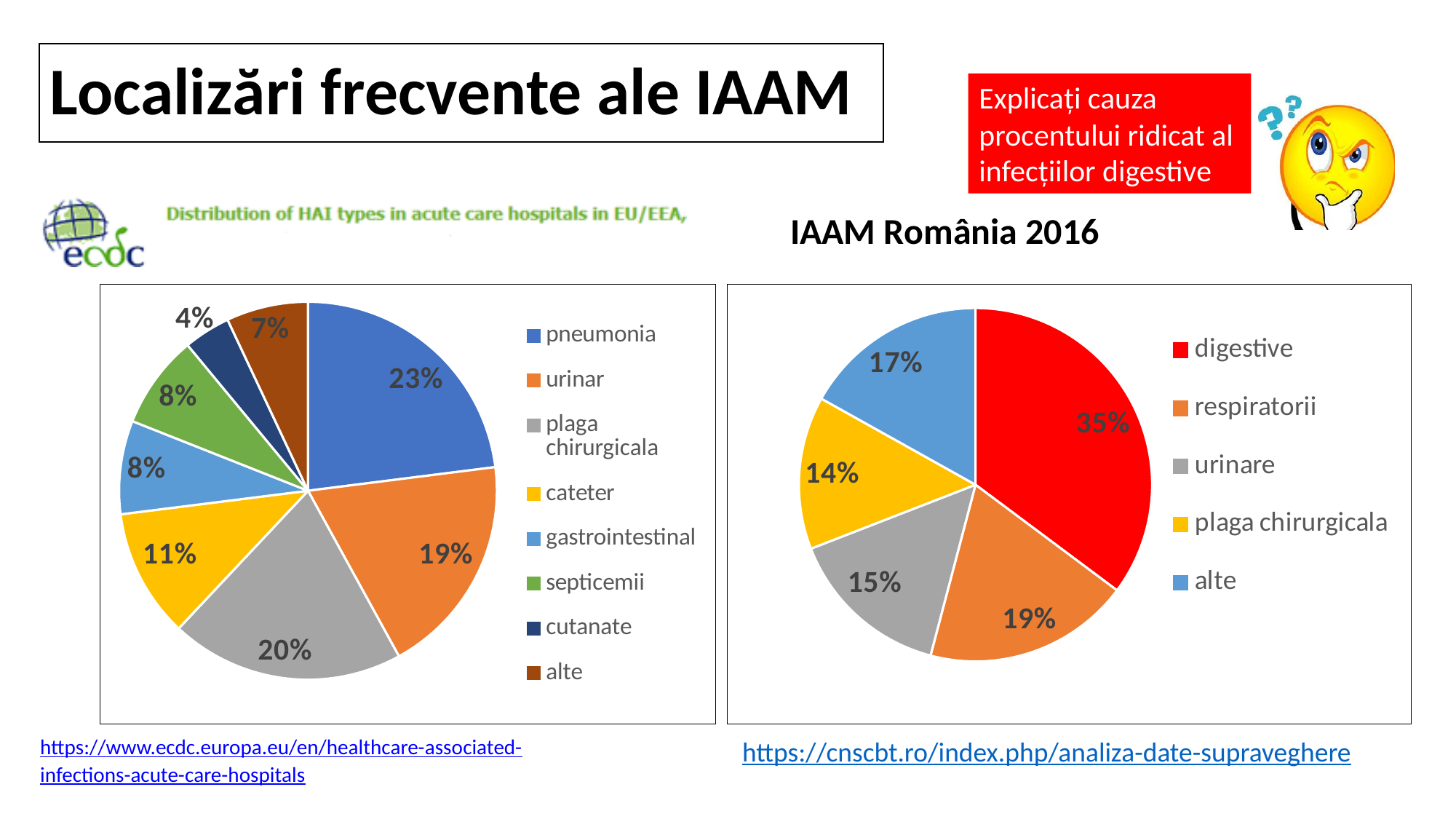
In the left pie chart (EU/EEA), how many categories does the legend list? 8 In the left pie chart (EU/EEA), what percentage is plaga chirurgicala? 20% In the right pie chart (IAAM România 2016), which category has the smallest share? plaga chirurgicala What type of chart is used for IAAM România 2016? pie chart In the left pie chart (Distribution of HAI types in acute care hospitals in EU/EEA), what percentage is pneumonia? 23% In the left pie chart (EU/EEA), which category has the smallest share? cutanate In the right pie chart (IAAM România 2016), which is larger, respiratorii or urinare? respiratorii In the right pie chart (IAAM România 2016), how many categories are shown? 5 In the right pie chart (IAAM România 2016), what percentage is digestive? 35% In the left pie chart (EU/EEA), what is the difference between the urinar share and the cateter share? 8% In the right pie chart (IAAM România 2016), what percentage is alte? 17% In the left pie chart (EU/EEA), which category has the largest share? pneumonia